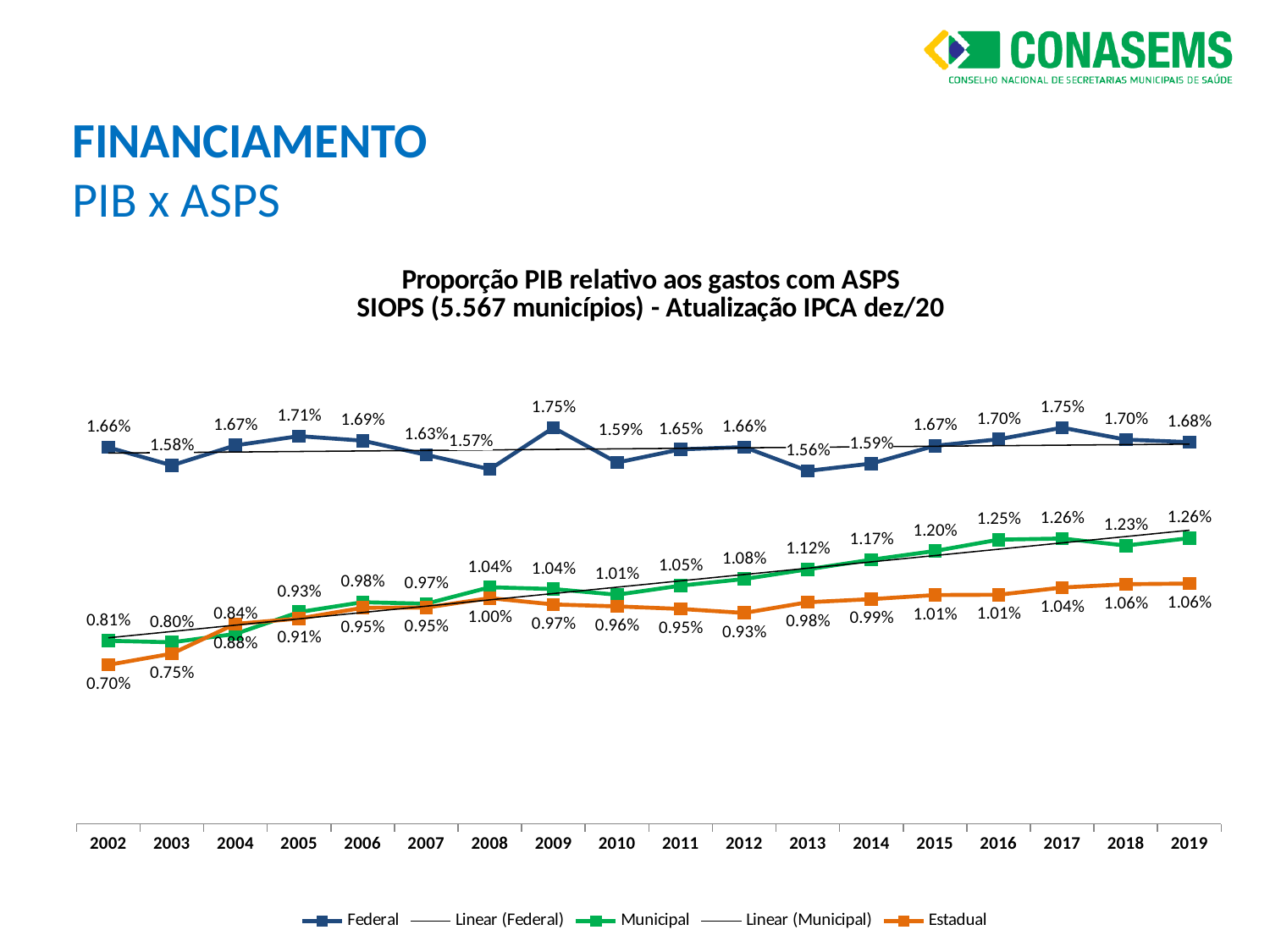
What is the Federal value for 2009? 1.75% In 2003, which is larger, the Municipal value or the Estadual value? Municipal In which year is the Estadual series at its lowest? 2002 What is the Municipal value for 2014? 1.17% How many years are shown on the x axis? 18 Does the Municipal series generally rise or fall from 2002 to 2019? Rise By how much did the Municipal value increase from 2002 to 2019? 0.45% How many entries does the legend list? 5 What is the difference between the Federal and Municipal values in 2019? 0.42% Which series is drawn in orange? Estadual What kind of chart is shown on the slide? Line chart What is the Estadual value for 2002? 0.70%